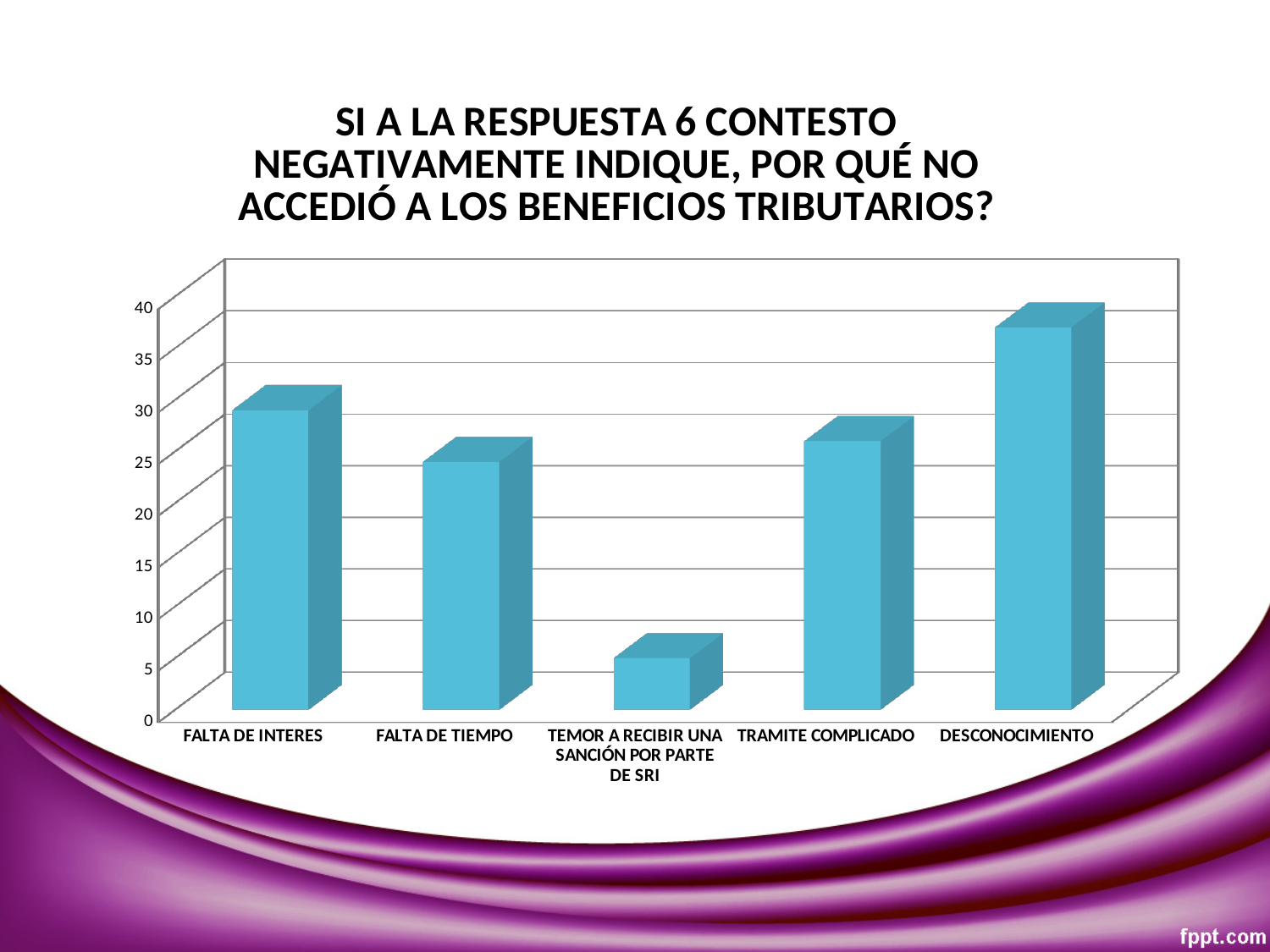
What kind of chart is shown on the slide? bar chart Is the value for FALTA DE TIEMPO greater or less than 30? less Is the value for FALTA DE INTERES greater or less than 25? greater Is the value for TEMOR A RECIBIR UNA SANCIÓN POR PARTE DE SRI greater or less than 10? less What is the highest value shown on the vertical axis of the chart? 40 Which is larger, the value for DESCONOCIMIENTO or the value for TRAMITE COMPLICADO? DESCONOCIMIENTO Which is larger, the value for FALTA DE INTERES or the value for FALTA DE TIEMPO? FALTA DE INTERES Which category has the highest bar in the chart? DESCONOCIMIENTO Which category has the lowest bar in the chart? TEMOR A RECIBIR UNA SANCIÓN POR PARTE DE SRI How many categories are shown on the x axis of the chart? 5